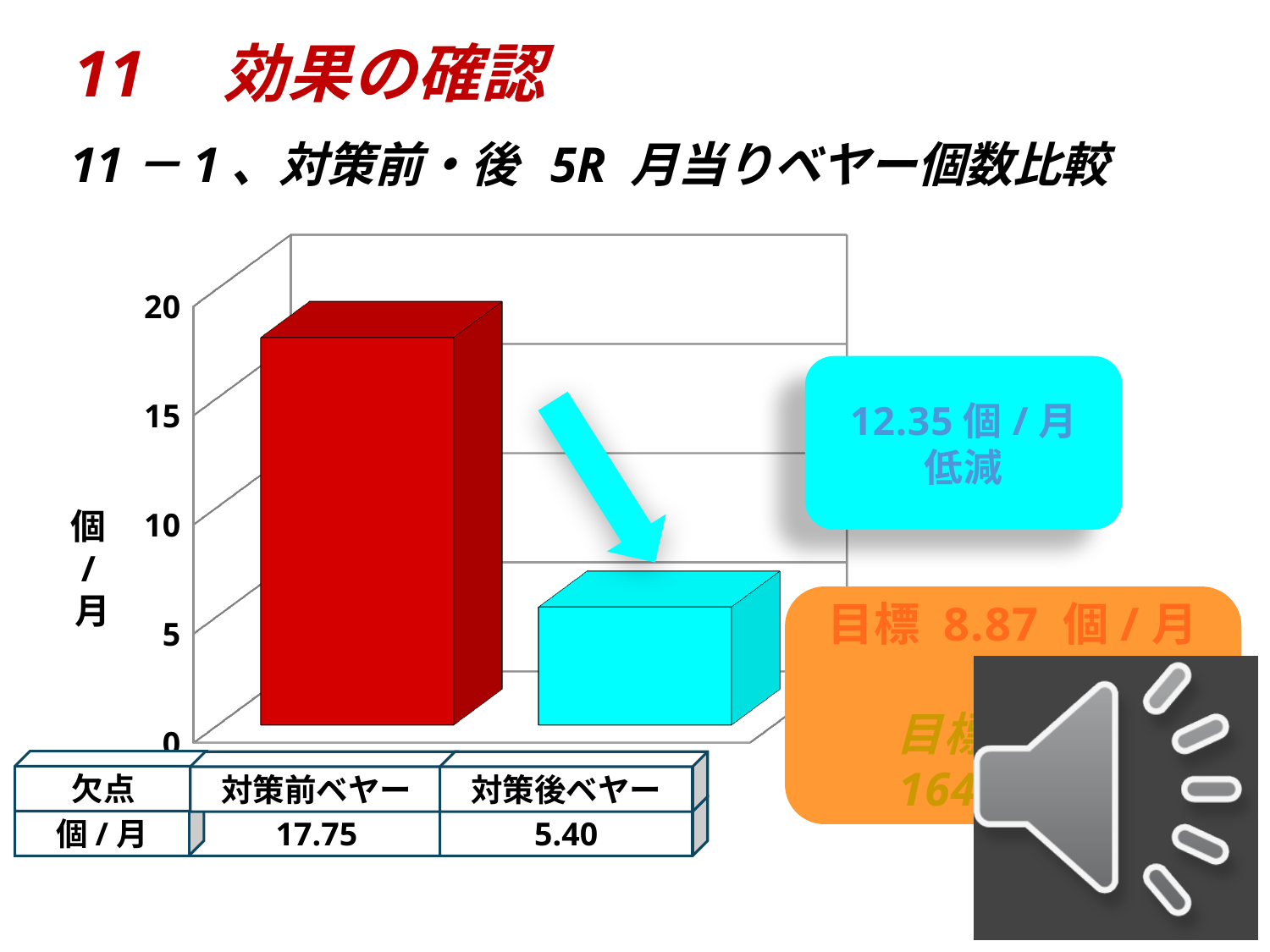
What is the label on the vertical axis of the chart? 個/月 What kind of chart is shown on the slide? bar chart Do the values rise or fall from 対策前ベヤー to 対策後ベヤー? fall How many bars are plotted in the chart? 2 What is the value for 対策後ベヤー? 5.40 Is the value for 対策後ベヤー greater or less than 10? less What is the difference between the values for 対策前ベヤー and 対策後ベヤー? 12.35 Which category has the highest value? 対策前ベヤー What is the value for 対策前ベヤー? 17.75 Is the value for 対策前ベヤー greater or less than 15? greater Which is larger, the value for 対策前ベヤー or 対策後ベヤー? 対策前ベヤー Which category has the lowest value? 対策後ベヤー